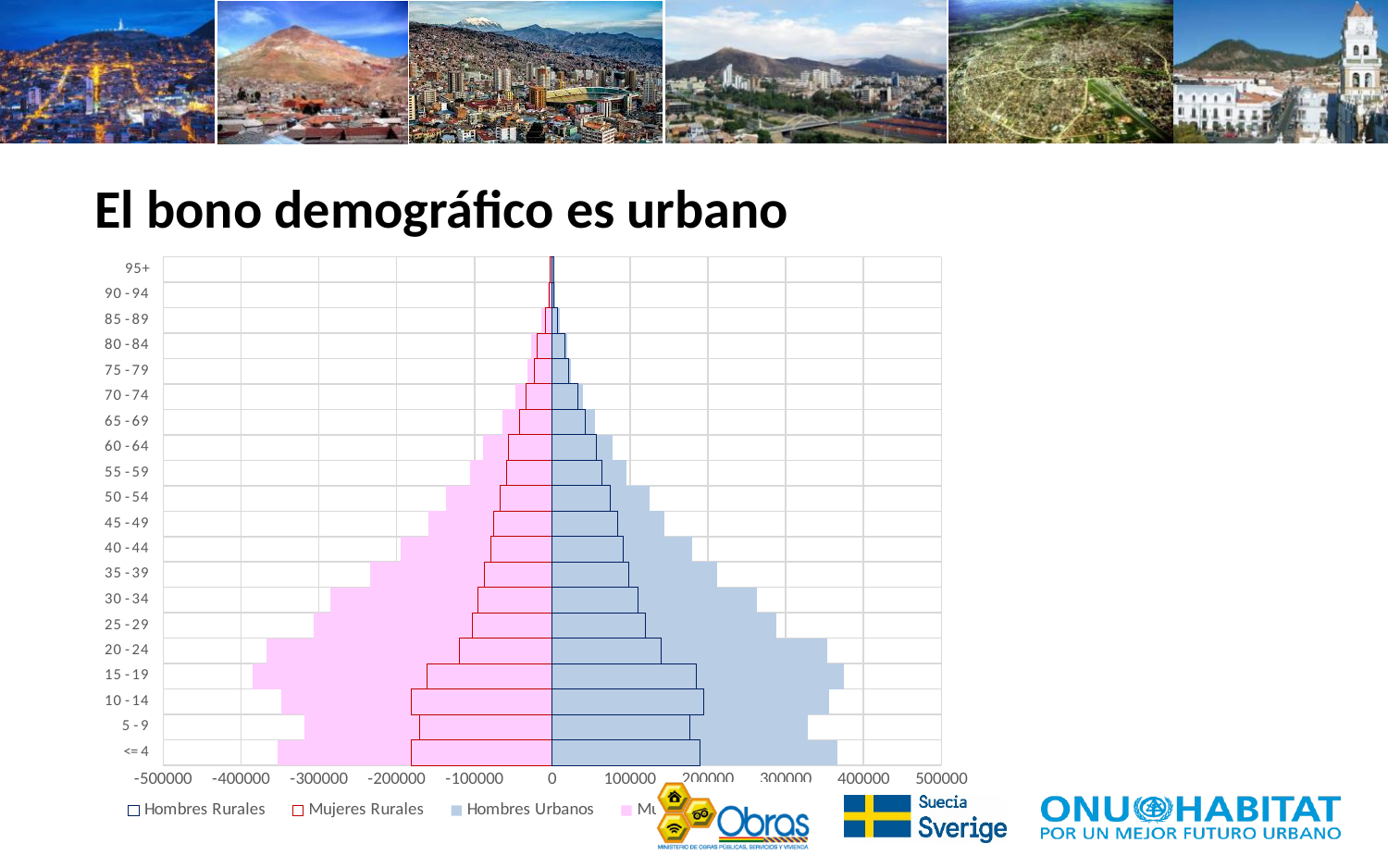
Which series is drawn with a light blue filled bar according to the legend? Hombres Urbanos Which age group has the larger Hombres Rurales value, 15 - 19 or 60 - 64? 15 - 19 What is the title of the slide containing the chart? El bono demográfico es urbano Is the Mujeres Rurales bar for the 65 - 69 age group longer or shorter than 100000 in magnitude? less Which age group has the smallest Hombres Rurales value? 95+ Is the Hombres Urbanos bar for the 15 - 19 age group extended beyond 300000 or not? greater Moving from the 20 - 24 age group up to the 95+ age group, do the Hombres Rurales bars get longer or shorter? shorter How many series does the chart legend list? 4 How many age-group categories are shown on the vertical axis of the chart? 20 What type of chart is shown on the slide? bar chart Is the Hombres Rurales value for the 15 - 19 age group greater or less than 100000? greater